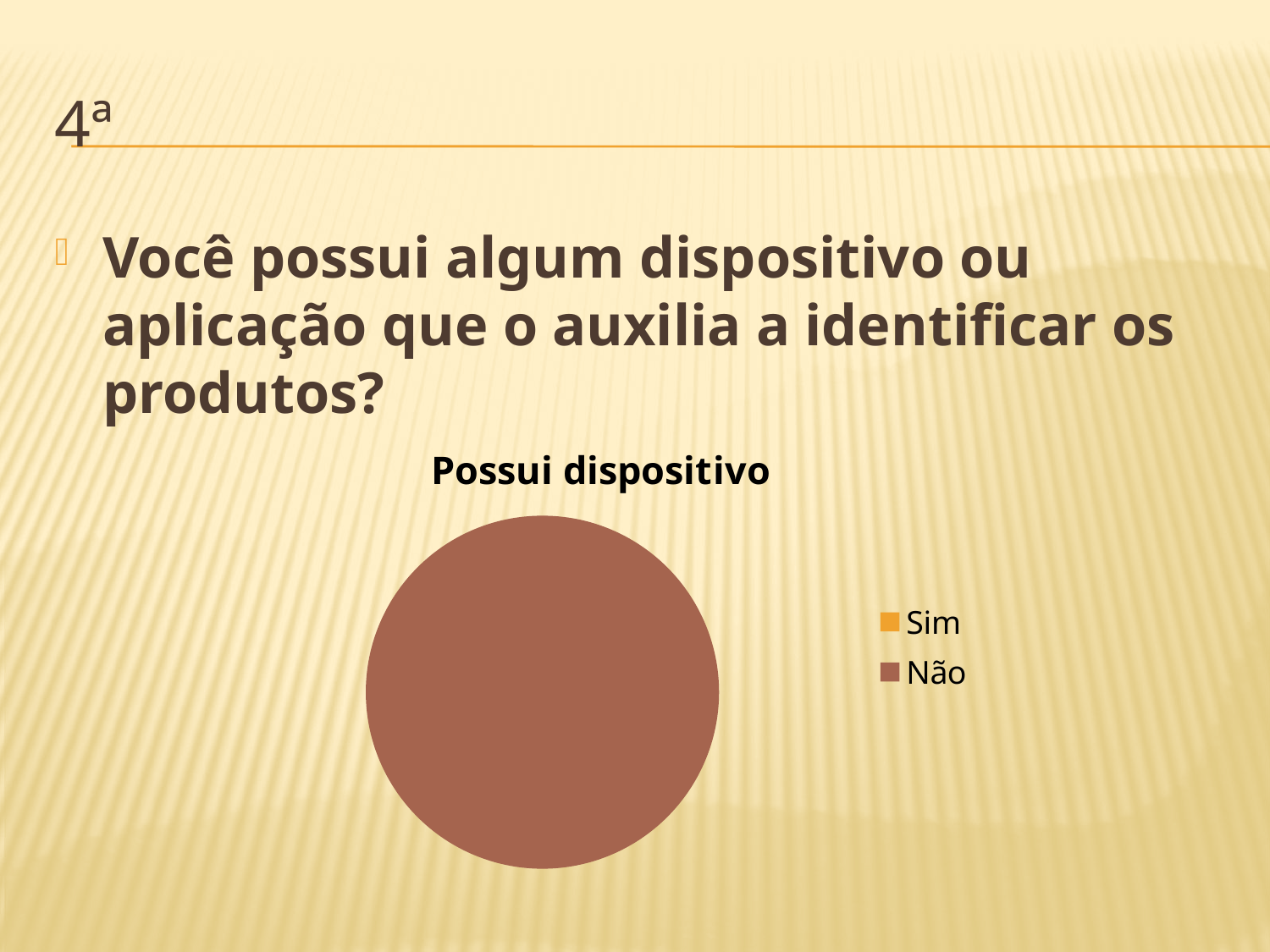
What is the title of the chart? Possui dispositivo Which category has the larger share, Sim or Não? Não What colour represents Não in the chart? brown Which category takes the largest share of the pie? Não What kind of chart is shown on the slide? pie chart How many entries does the chart legend list? 2 Which category takes the smallest share of the pie? Sim How many categories are listed in the chart legend? 2